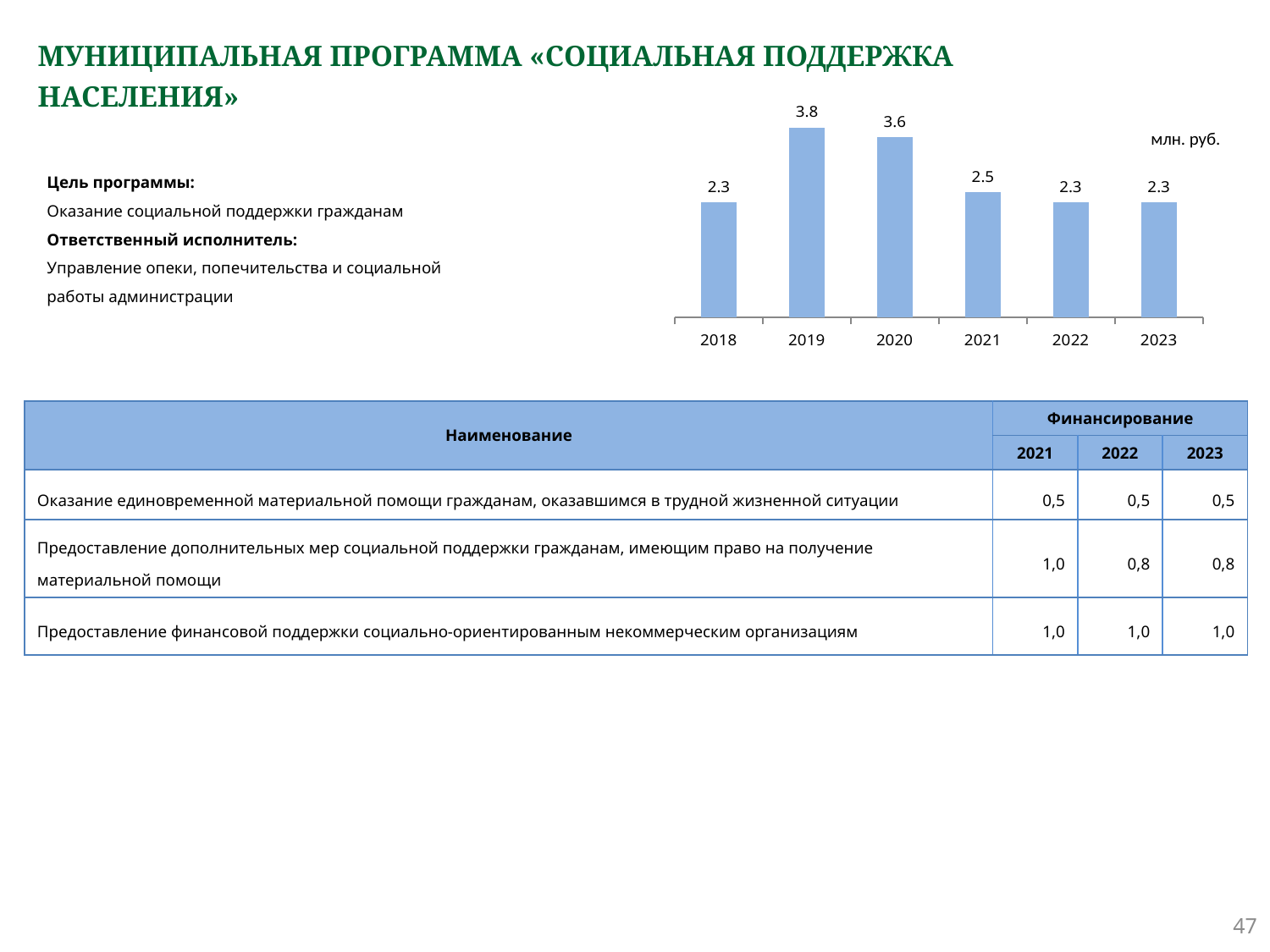
What kind of chart is shown on the slide? bar chart Which is larger in the bar chart, the value for 2020 or the value for 2022? 2020 How many years are shown on the x axis of the bar chart? 6 What is the difference between the values for 2019 and 2018 in the bar chart? 1.5 What is the value for 2019 in the bar chart? 3.8 Which year has the highest value in the bar chart? 2019 What is the value for 2023 in the bar chart? 2.3 What is the value for 2020 in the bar chart? 3.6 What is the value for 2021 in the bar chart? 2.5 What unit is indicated next to the bar chart? млн. руб. What is the difference between the values for 2020 and 2021 in the bar chart? 1.1 Does the value in the bar chart rise or fall from 2019 to 2021? fall